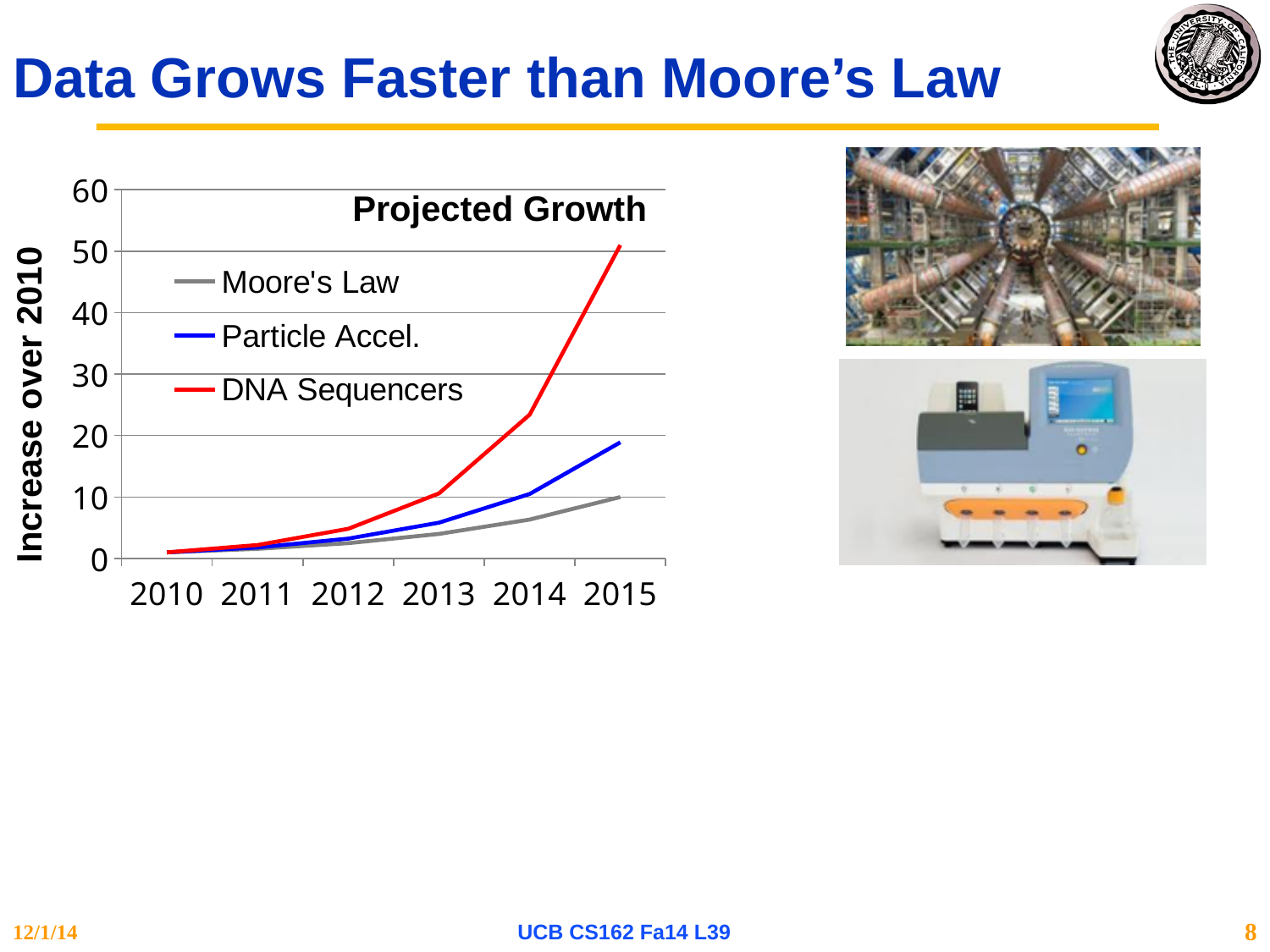
Is the value for DNA Sequencers in 2014 greater or less than 20? greater How many series does the legend of the chart list? 3 What kind of chart is shown on the slide? line chart How many years are shown along the x axis of the chart? 6 What is the label on the y axis of the chart? Increase over 2010 Is the value for Particle Accel. in 2015 greater or less than 30? less Which series has the highest value in 2015? DNA Sequencers What is the title of the chart? Projected Growth Do the values for DNA Sequencers rise or fall from 2010 to 2015? rise In 2014, which is larger: the value for Particle Accel. or the value for Moore's Law? Particle Accel. Is the value for DNA Sequencers in 2015 greater or less than 40? greater Which series has the lowest value in 2015? Moore's Law